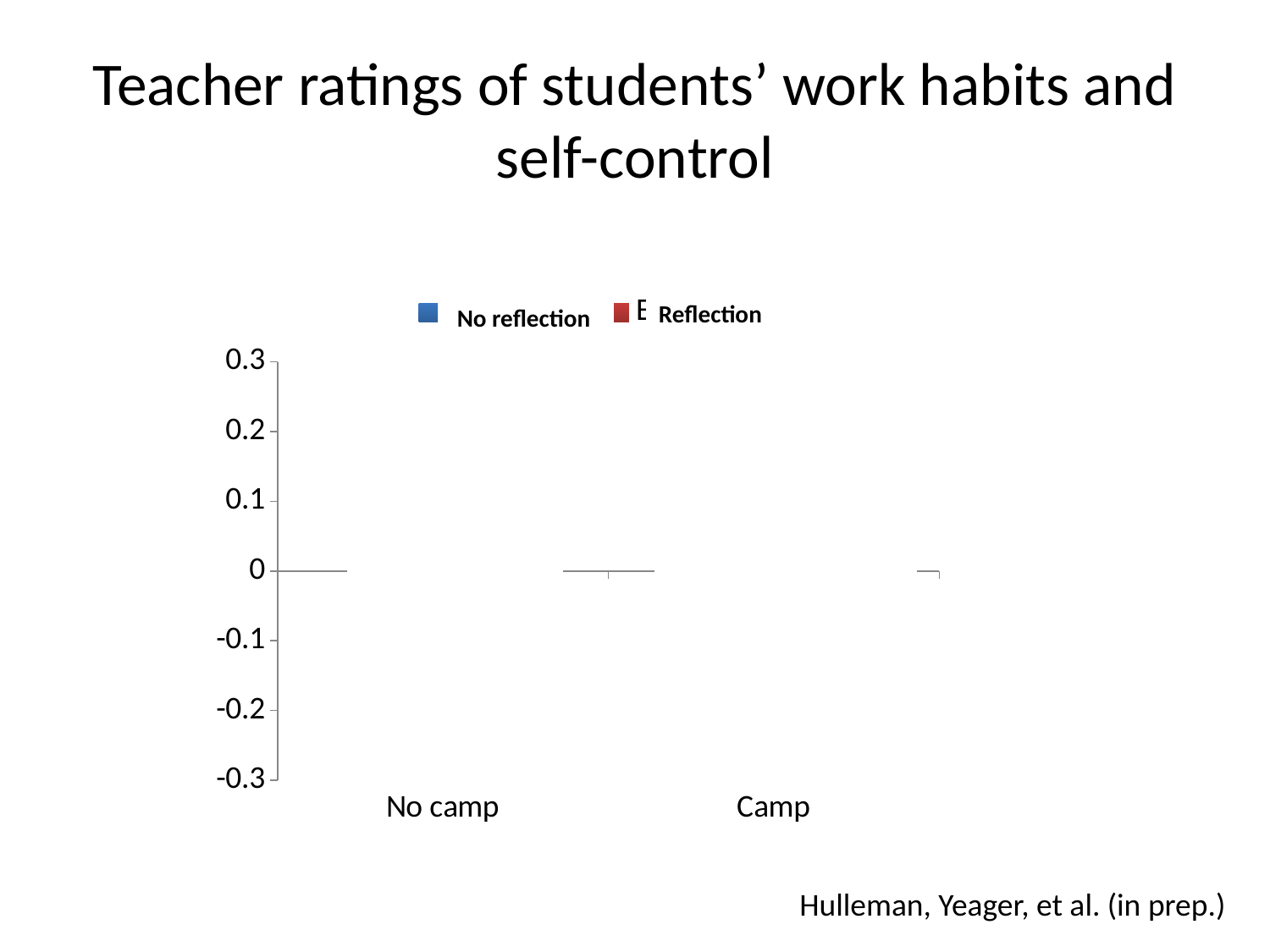
What are the two series named in the legend? No reflection and Reflection What is the highest value shown on the y axis? 0.3 How many series does the legend list? 2 What is the lowest value shown on the y axis? -0.3 Is the value for Reflection in the No camp group greater or less than -0.3? greater Is the value for No reflection in the Camp group greater or less than 0.3? less What kind of chart is shown on the slide? bar chart What are the categories on the x axis? No camp and Camp How many categories are shown on the x axis? 2